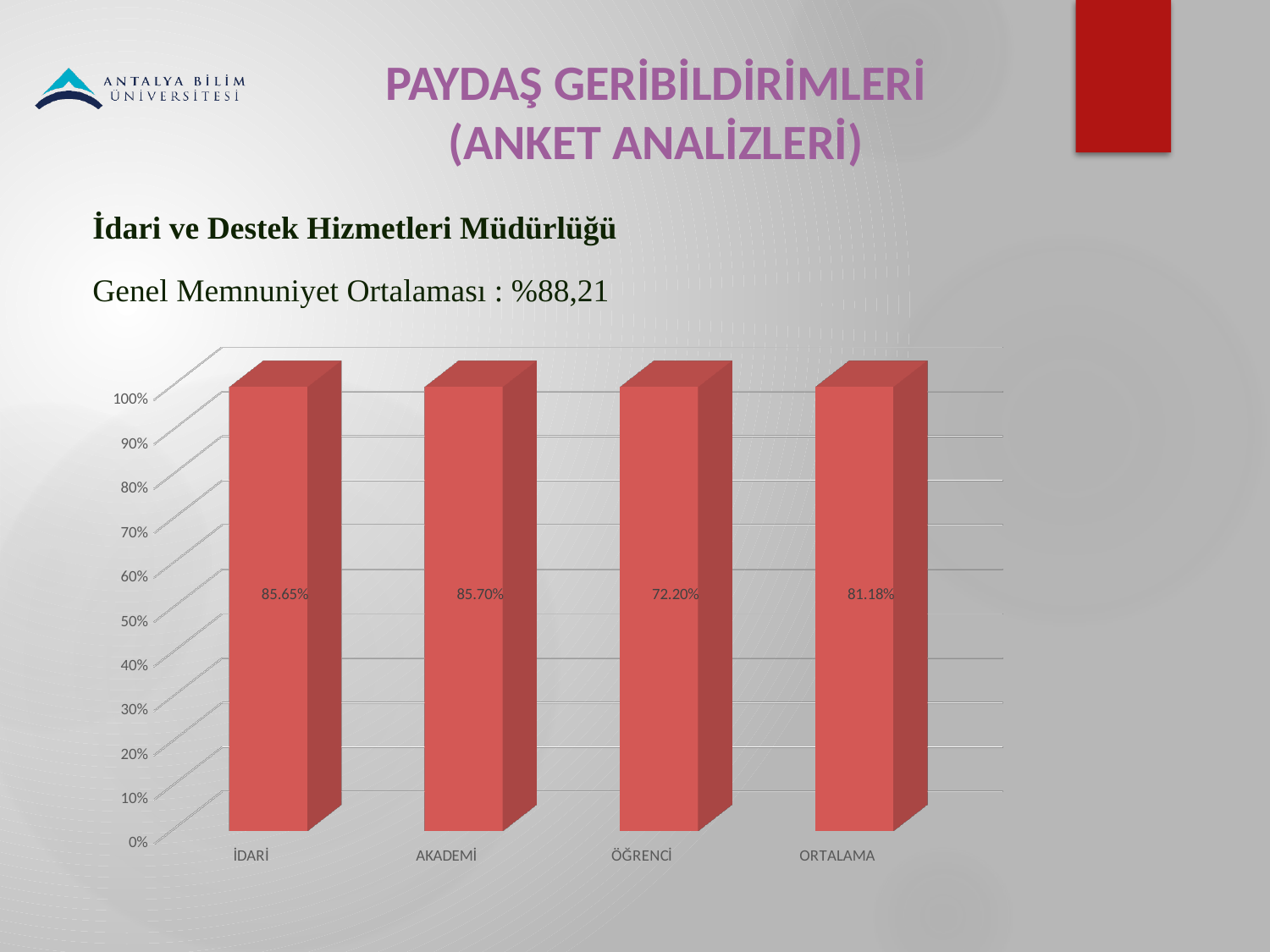
How many categories are shown on the x axis? 4 Which is larger, the value for ÖĞRENCİ or the value for ORTALAMA? ORTALAMA What is the value for ÖĞRENCİ? 72.20% What is the value for ORTALAMA? 81.18% What is the difference between the values for İDARİ and ORTALAMA? 4.47% Which category has the highest value? AKADEMİ What colour are the bars in the chart? Red What is the difference between the values for AKADEMİ and ÖĞRENCİ? 13.50% What kind of chart is shown on the slide? Bar chart What is the value for AKADEMİ? 85.70% What is the value for İDARİ? 85.65% Which category has the lowest value? ÖĞRENCİ